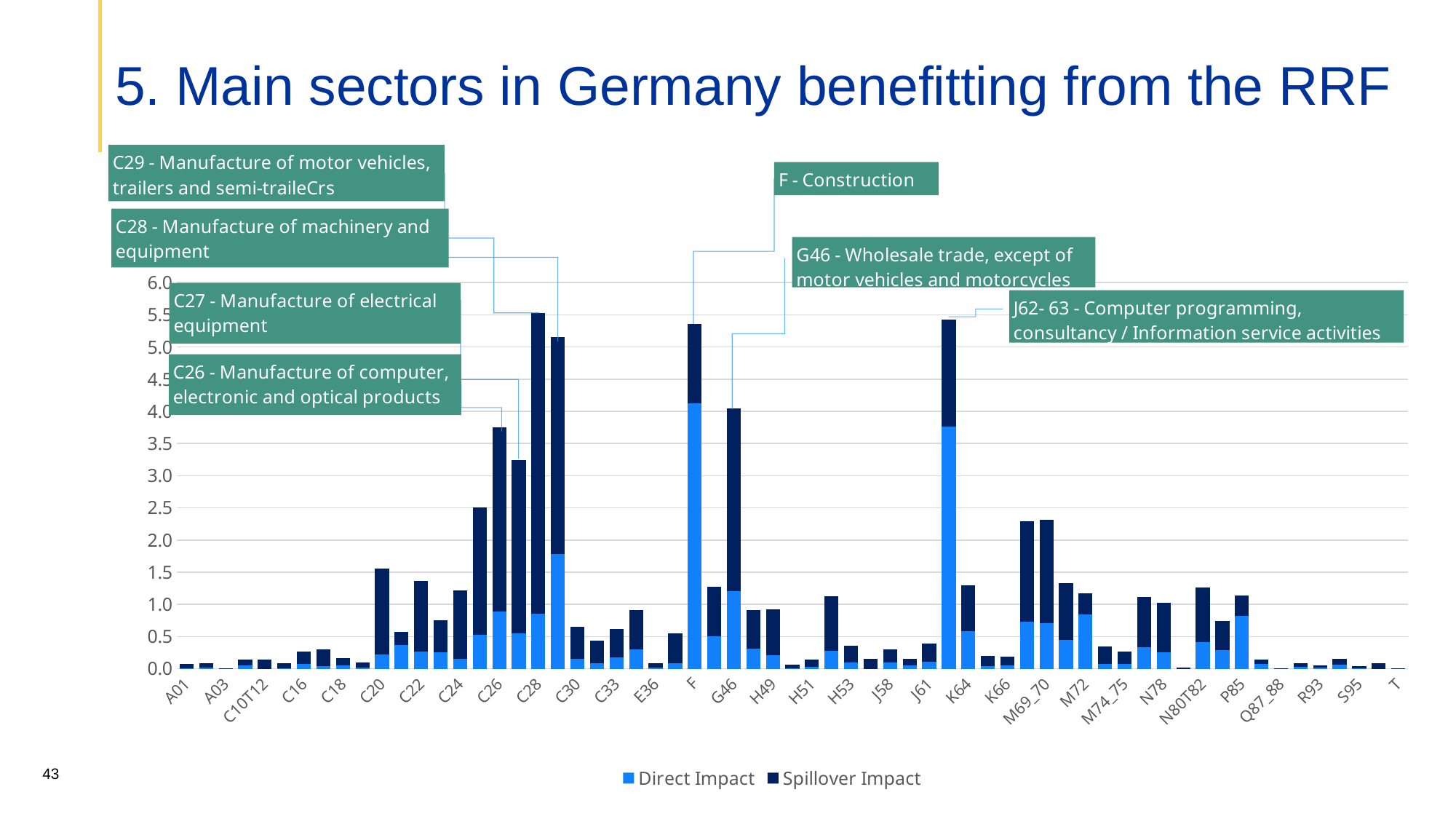
What is the title of the slide containing the chart? 5. Main sectors in Germany benefitting from the RRF Is the Direct Impact value for F greater or less than 3.5? greater Is the total value for K64 greater or less than 5.0? less How many series does the legend list? 2 Is the total value for G46 greater or less than 3.5? greater What are the two series named in the legend? Direct Impact and Spillover Impact Which has the larger total bar, F or G46? F What kind of chart is shown on the slide? Stacked bar chart Which has the larger total bar, C20 or C30? C20